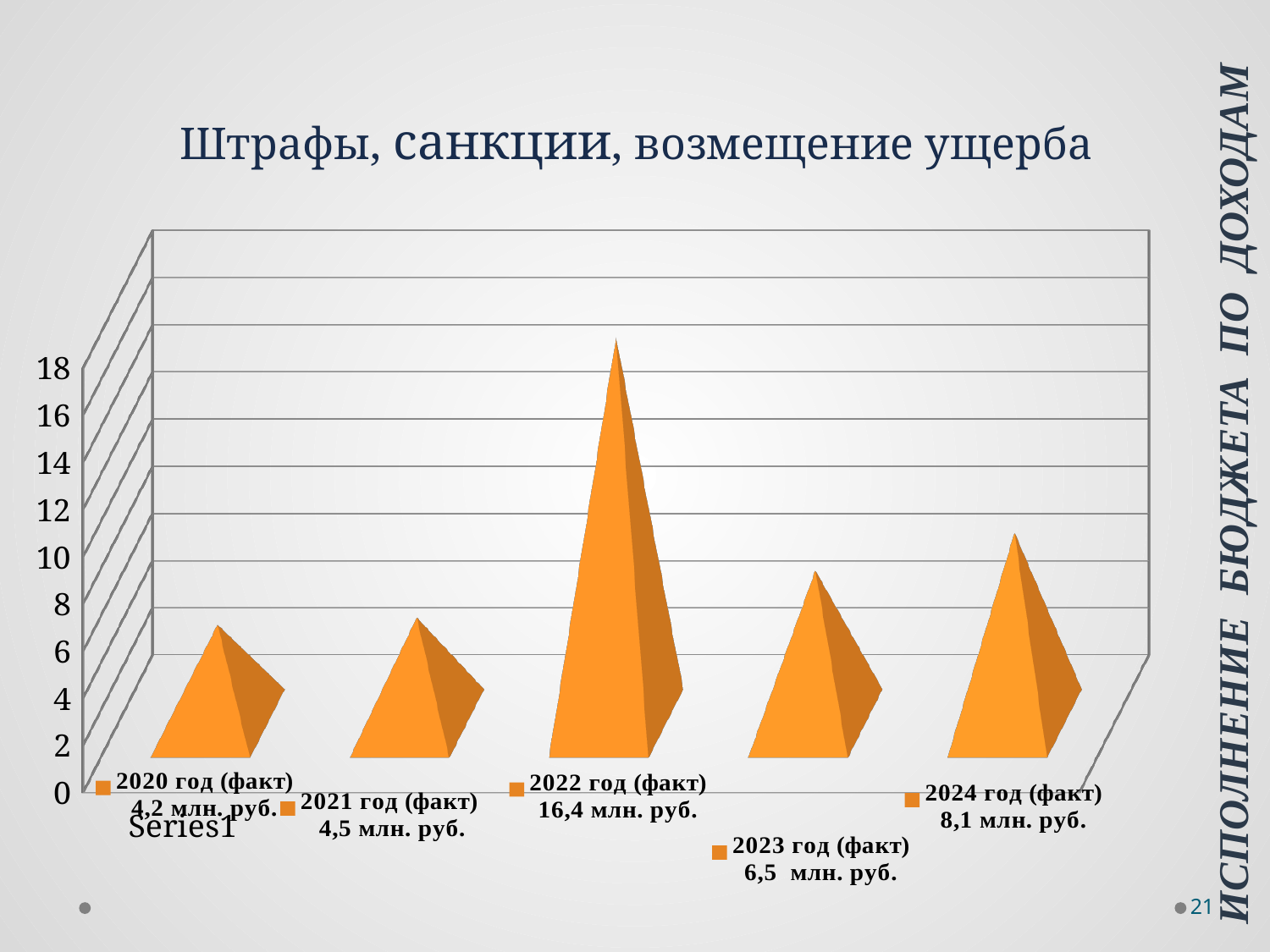
What kind of chart is shown on the slide? bar chart What is the title of the chart? Штрафы, санкции, возмещение ущерба How many categories are plotted on the chart? 5 What is the value for 2024 год (факт)? 8,1 млн. руб. What is the value for 2020 год (факт)? 4,2 млн. руб. What is the difference between the values for 2022 год (факт) and 2024 год (факт)? 8,3 млн. руб. Is the value for 2022 год (факт) greater or less than 14? greater What is the value for 2022 год (факт)? 16,4 млн. руб. Which is larger, the value for 2023 год (факт) or 2024 год (факт)? 2024 год (факт) Which year has the lowest value? 2020 год (факт) What is the difference between the values for 2023 год (факт) and 2021 год (факт)? 2,0 млн. руб. Which year has the highest value? 2022 год (факт)